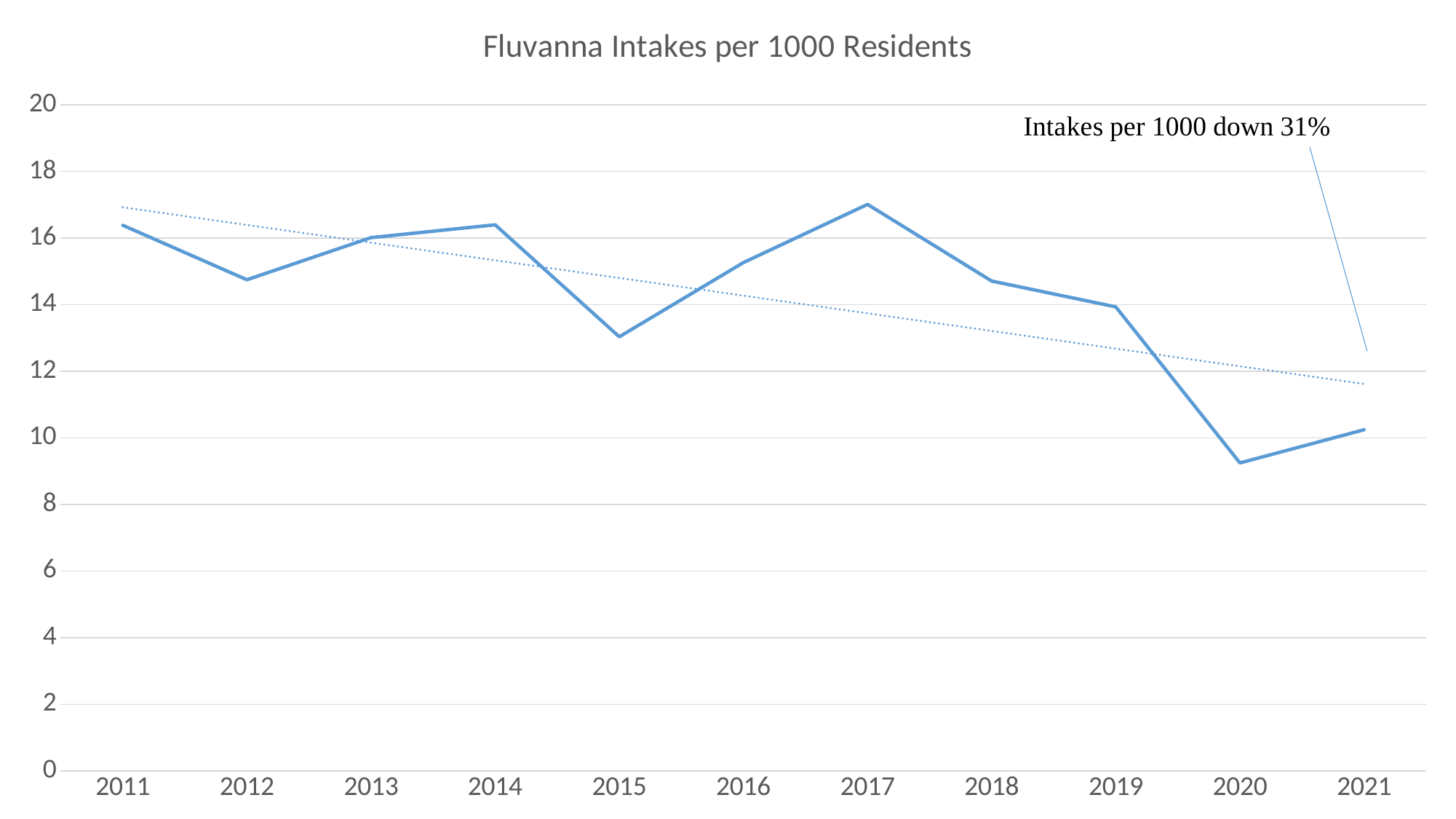
Is the value for 2012 greater or less than 16? less Is the value for 2020 greater or less than 10? less What kind of chart is shown on the slide? line chart Overall, do intakes per 1000 residents rise or fall from 2011 to 2021? fall Is the value for 2017 greater or less than 16? greater Which year has the highest intakes per 1000 residents? 2017 Which year has the lowest intakes per 1000 residents? 2020 Which year has the larger value, 2015 or 2016? 2016 What is the title of the chart? Fluvanna Intakes per 1000 Residents What does the annotation on the chart say about the change in intakes per 1000? Intakes per 1000 down 31% How many years are plotted along the x axis? 11